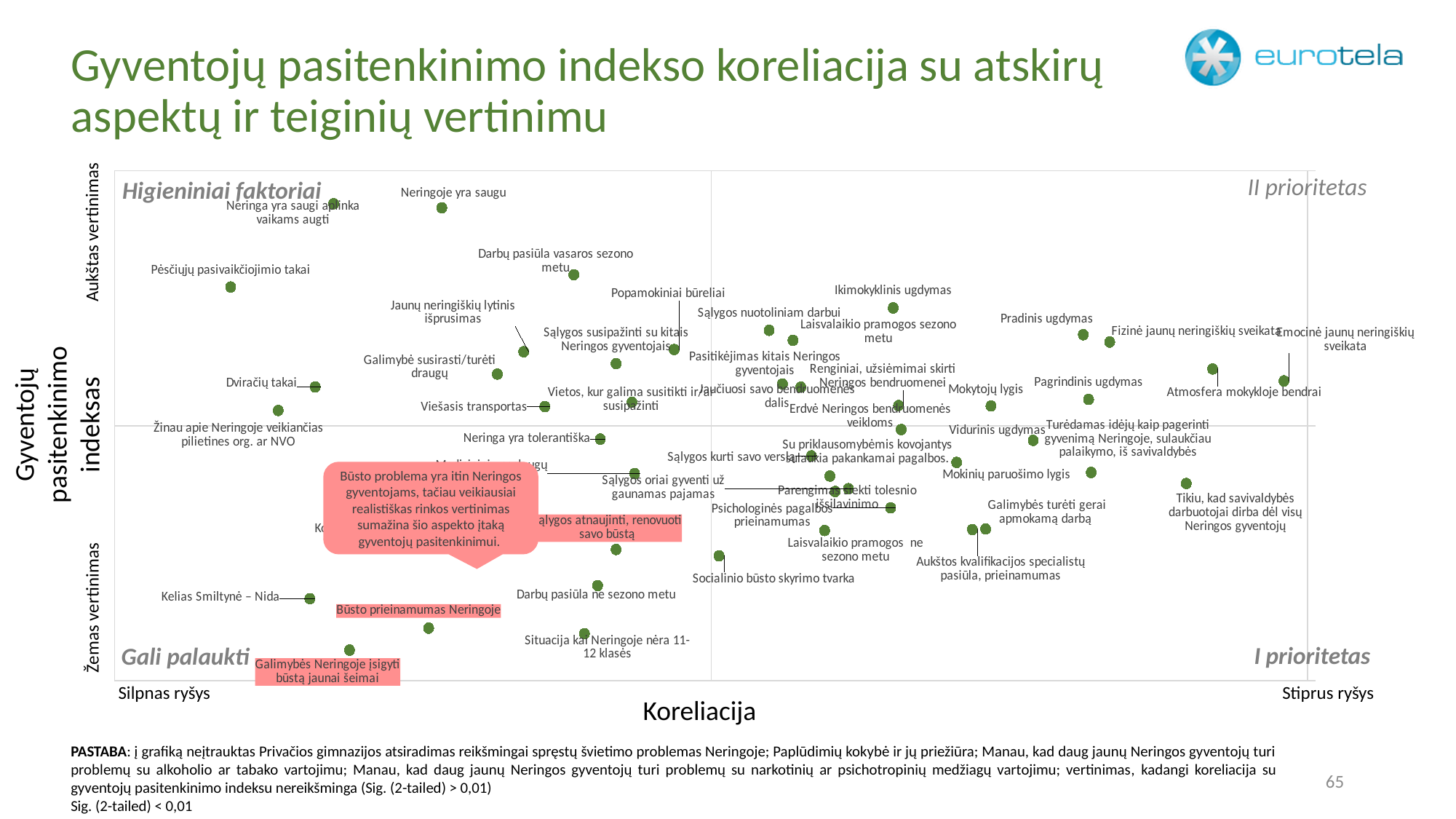
In which labelled quadrant does the point 'Pradinis ugdymas' fall? II prioritetas What is the label of the horizontal axis of the chart? Koreliacija Which is positioned higher on the vertical axis: 'Pradinis ugdymas' or 'Socialinio būsto skyrimo tvarka'? Pradinis ugdymas In which labelled quadrant does the point 'Kelias Smiltynė – Nida' fall? Gali palaukti What is the label shown in the bottom-right quadrant of the chart? I prioritetas Which is positioned higher on the vertical axis: 'Neringoje yra saugu' or 'Darbų pasiūla ne sezono metu'? Neringoje yra saugu Which is positioned higher on the vertical axis: 'Dviračių takai' or 'Viešasis transportas'? Dviračių takai Which point lies furthest to the right on the Koreliacija axis? Emocinė jaunų neringiškių sveikata Which point lies furthest to the left on the Koreliacija axis? Pėsčiųjų pasivaikščiojimio takai What kind of chart is shown on the slide? Scatter chart Which point has the lowest value on the vertical axis (Gyventojų pasitenkinimo indeksas)? Galimybės Neringoje įsigyti būstą jaunai šeimai